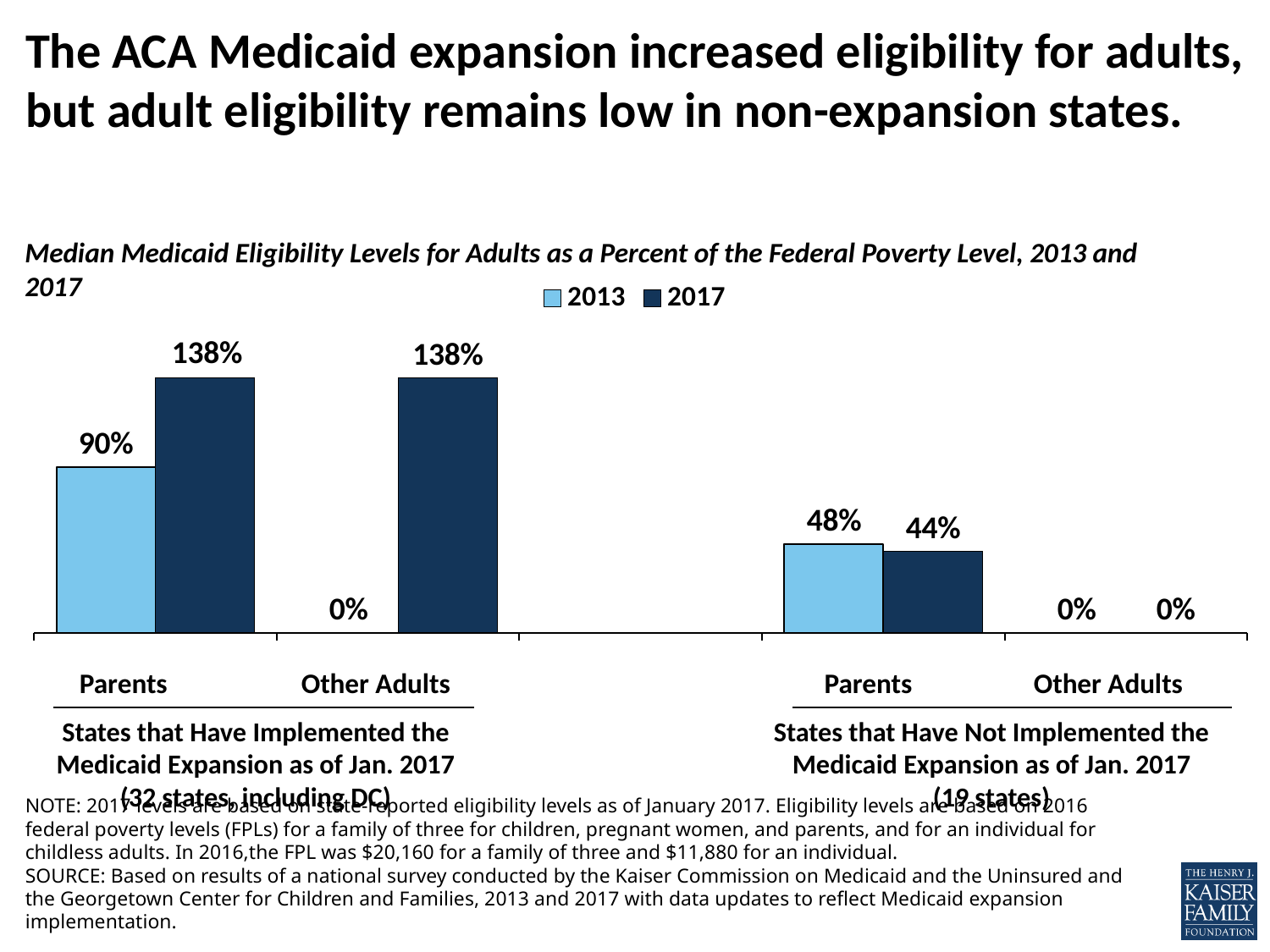
What was the median eligibility level for parents in non-expansion states in 2017? 44% What was the median eligibility level for other adults in expansion states in 2013? 0% By how many percentage points did the median eligibility level for parents in expansion states increase from 2013 to 2017? 48 percentage points What is the difference between the 2013 and 2017 median eligibility levels for parents in non-expansion states? 4 percentage points What was the median Medicaid eligibility level for parents in expansion states in 2013? 90% Which is larger: the 2017 eligibility level for parents in expansion states or the 2017 eligibility level for parents in non-expansion states? Expansion states Which colour represents 2017 in the chart? Dark navy blue What type of chart is shown on the slide? Bar chart How many series does the legend list? 2 For parents in non-expansion states, was the median eligibility level higher in 2013 or 2017? 2013 What was the median Medicaid eligibility level for parents in expansion states in 2017? 138% What was the median eligibility level for other adults in non-expansion states in 2017? 0%